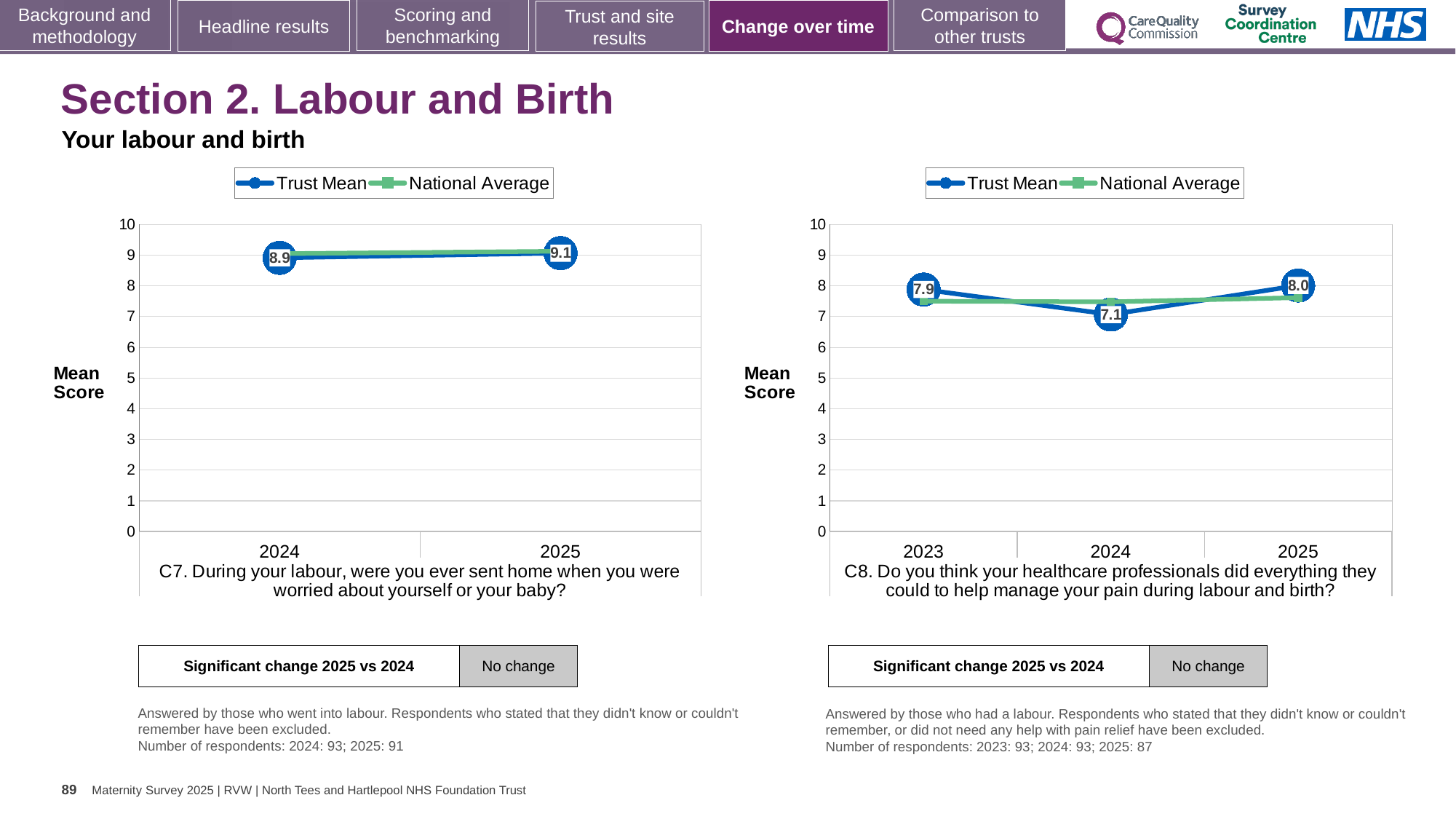
What kind of chart is the C7 chart (left)? Line chart In the C8 chart (right), what is the Trust Mean for 2024? 7.1 In the C7 chart (left), what is the Trust Mean for 2025? 9.1 In the C8 chart (right), which year has the highest Trust Mean? 2025 How many series does the legend of the C7 chart (left) list? 2 How many years are plotted on the x axis of the C8 chart (right)? 3 In the C8 chart (right), which year has the lowest Trust Mean? 2024 In the C7 chart (left), what is the difference between the Trust Mean for 2025 and 2024? 0.2 In the C8 chart (right), what is the difference between the Trust Mean for 2025 and 2024? 0.9 In the C8 chart (right), is the Trust Mean for 2023 greater or less than the Trust Mean for 2024? greater In the C8 chart (right), what is the Trust Mean for 2025? 8.0 In the C7 chart (left), what is the Trust Mean for 2024? 8.9